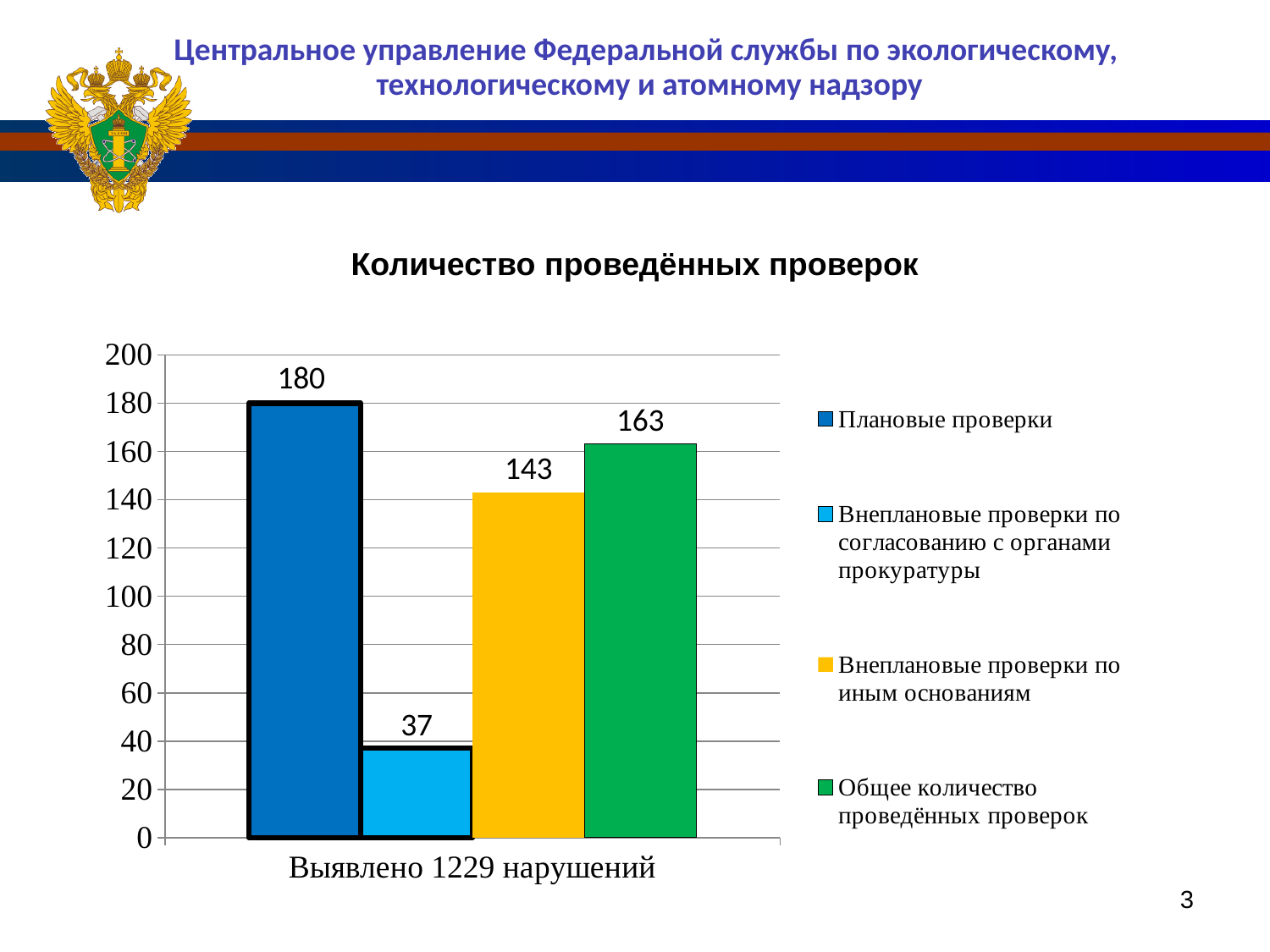
What is the title of the chart? Количество проведённых проверок What is the difference between Внеплановые проверки по иным основаниям and Внеплановые проверки по согласованию с органами прокуратуры? 106 What is the value for Внеплановые проверки по иным основаниям? 143 What kind of chart is shown on the slide? Bar chart How many series does the legend list? 4 What is the value for Общее количество проведённых проверок? 163 Which is larger: Внеплановые проверки по иным основаниям or Общее количество проведённых проверок? Общее количество проведённых проверок Which series has the highest value? Плановые проверки What is the difference between Плановые проверки and Общее количество проведённых проверок? 17 Which series has the lowest value? Внеплановые проверки по согласованию с органами прокуратуры What is the value for Внеплановые проверки по согласованию с органами прокуратуры? 37 What is the value for Плановые проверки? 180